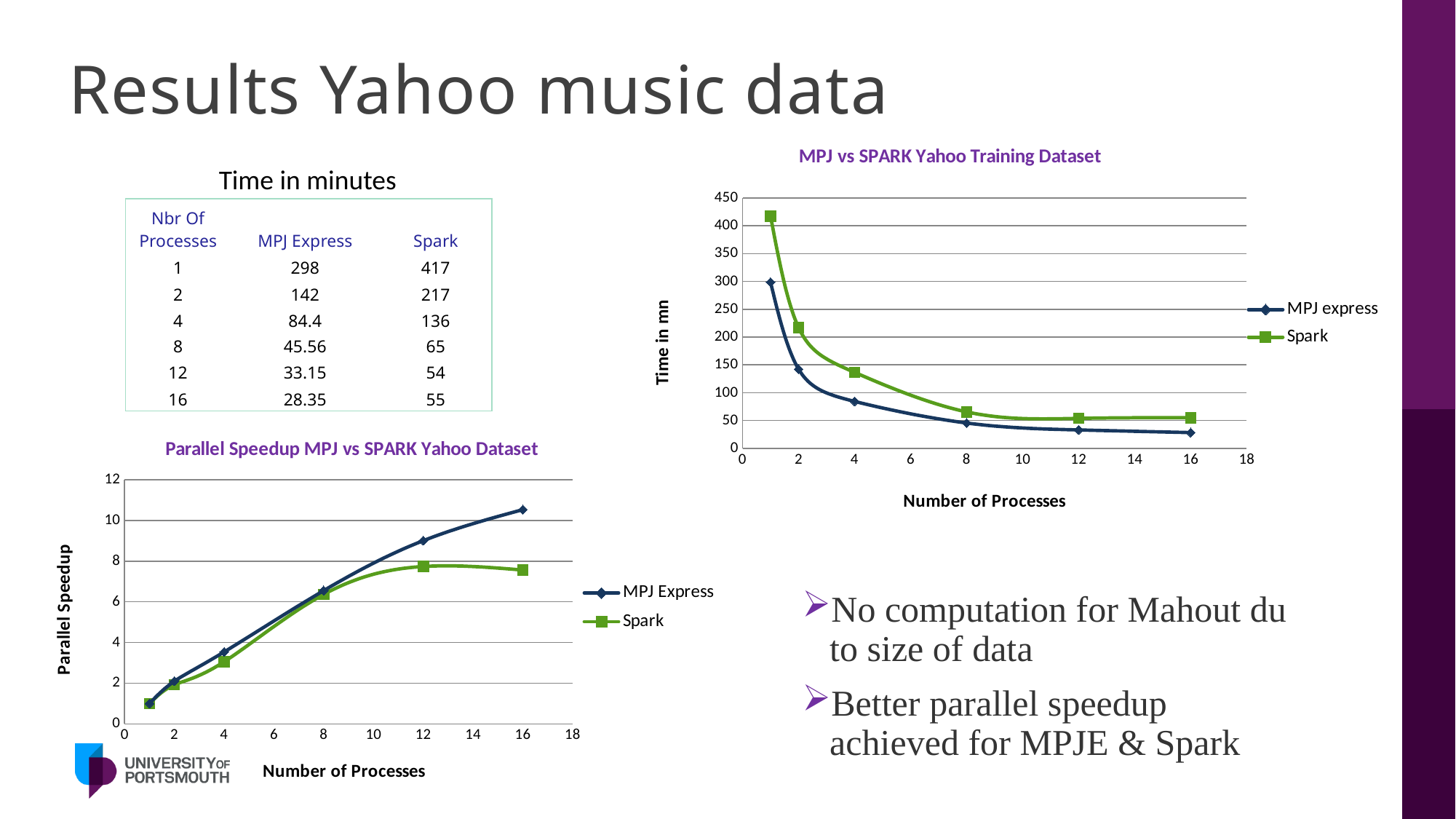
What kind of chart is the 'MPJ vs SPARK Yahoo Training Dataset' chart? Line chart In the 'MPJ vs SPARK Yahoo Training Dataset' chart, what is the MPJ Express time in minutes at 16 processes? 28.35 In the 'MPJ vs SPARK Yahoo Training Dataset' chart, how much longer does Spark take than MPJ Express at 1 process? 119 In the 'MPJ vs SPARK Yahoo Training Dataset' chart, does the MPJ express time rise or fall as the number of processes increases? Fall In the 'Parallel Speedup MPJ vs SPARK Yahoo Dataset' chart, is the Spark speedup at 16 processes greater or less than 8? less How many data points are plotted for the Spark series in the 'MPJ vs SPARK Yahoo Training Dataset' chart? 6 In the 'MPJ vs SPARK Yahoo Training Dataset' chart, at which number of processes is the Spark time highest? 1 How many series does the legend of the 'MPJ vs SPARK Yahoo Training Dataset' chart list? 2 In the 'MPJ vs SPARK Yahoo Training Dataset' chart, which series has the higher time at 8 processes? Spark In the 'Parallel Speedup MPJ vs SPARK Yahoo Dataset' chart, is the MPJ Express speedup at 16 processes greater or less than 10? greater What is the y-axis title of the 'Parallel Speedup MPJ vs SPARK Yahoo Dataset' chart? Parallel Speedup In the 'MPJ vs SPARK Yahoo Training Dataset' chart, what is the Spark time in minutes at 1 process? 417